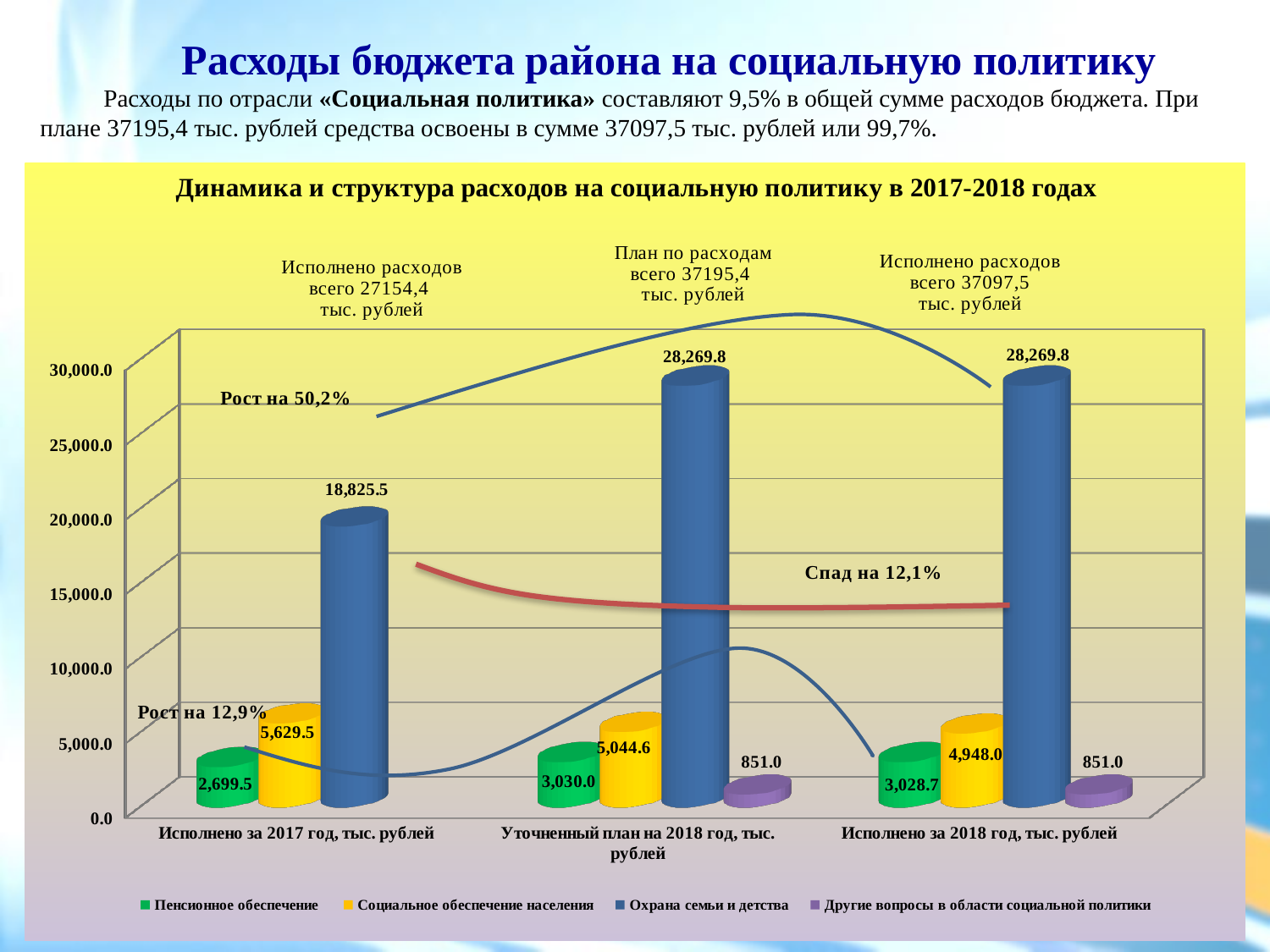
What is the value of «Социальное обеспечение населения» for «Уточненный план на 2018 год, тыс. рублей»? 5,044.6 Which series has the lowest value in the «Уточненный план на 2018 год, тыс. рублей» category? Другие вопросы в области социальной политики What is the difference between the «Охрана семьи и детства» values for «Уточненный план на 2018 год» and «Исполнено за 2017 год»? 9,444.3 What type of chart is shown under the title «Динамика и структура расходов на социальную политику в 2017-2018 годах»? Bar chart How many series does the chart legend list? 4 How many categories are shown along the x axis of the chart? 3 Does the value of «Социальное обеспечение населения» rise or fall from «Исполнено за 2017 год» to «Исполнено за 2018 год»? Fall What is the value of «Другие вопросы в области социальной политики» for «Исполнено за 2018 год, тыс. рублей»? 851.0 What is the value of «Пенсионное обеспечение» for «Исполнено за 2018 год, тыс. рублей»? 3,028.7 Which is larger: «Социальное обеспечение населения» for «Исполнено за 2017 год» or for «Исполнено за 2018 год»? Исполнено за 2017 год Which series has the highest value in the «Исполнено за 2018 год, тыс. рублей» category? Охрана семьи и детства What is the value of «Охрана семьи и детства» for «Исполнено за 2017 год, тыс. рублей»? 18,825.5